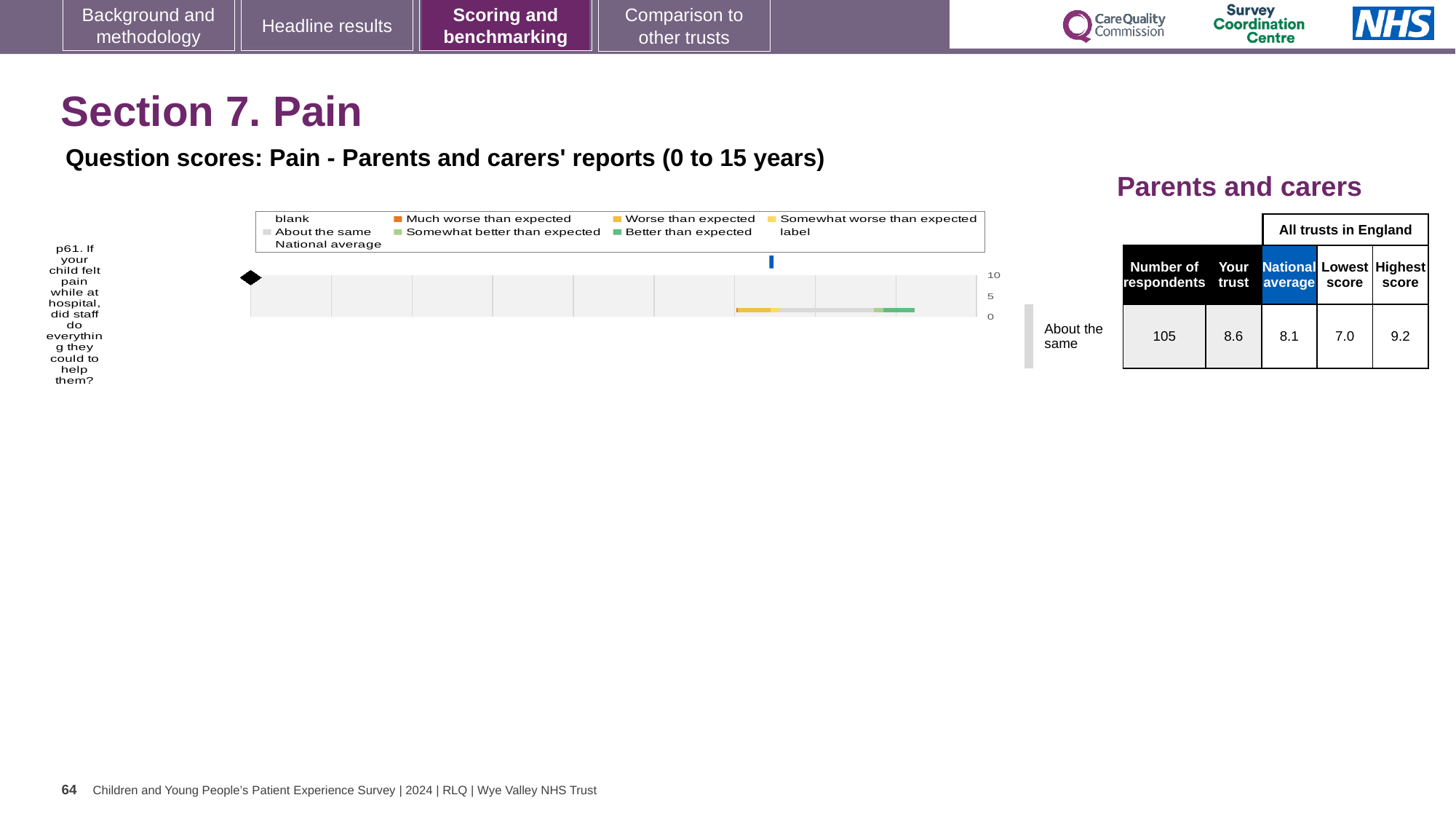
How many respondents answered p61, according to the table beside the chart? 105 How many survey questions (categories) are plotted in the chart? 1 What is the difference between the 'Your trust' score and the national average for p61? 0.5 What kind of chart is shown on the slide? bar chart According to the table beside the chart, what is the lowest score among all trusts in England for p61? 7.0 According to the table beside the chart, what is the national average score for p61? 8.1 According to the table beside the chart, what is the 'Your trust' score for p61? 8.6 Which is larger for p61: the 'Your trust' score or the national average? Your trust What is the difference between the highest and lowest scores among all trusts in England for p61? 2.2 What is the highest tick value shown on the chart's score axis? 10 According to the table beside the chart, what is the highest score among all trusts in England for p61? 9.2 What is the question number of the item plotted in the chart? p61